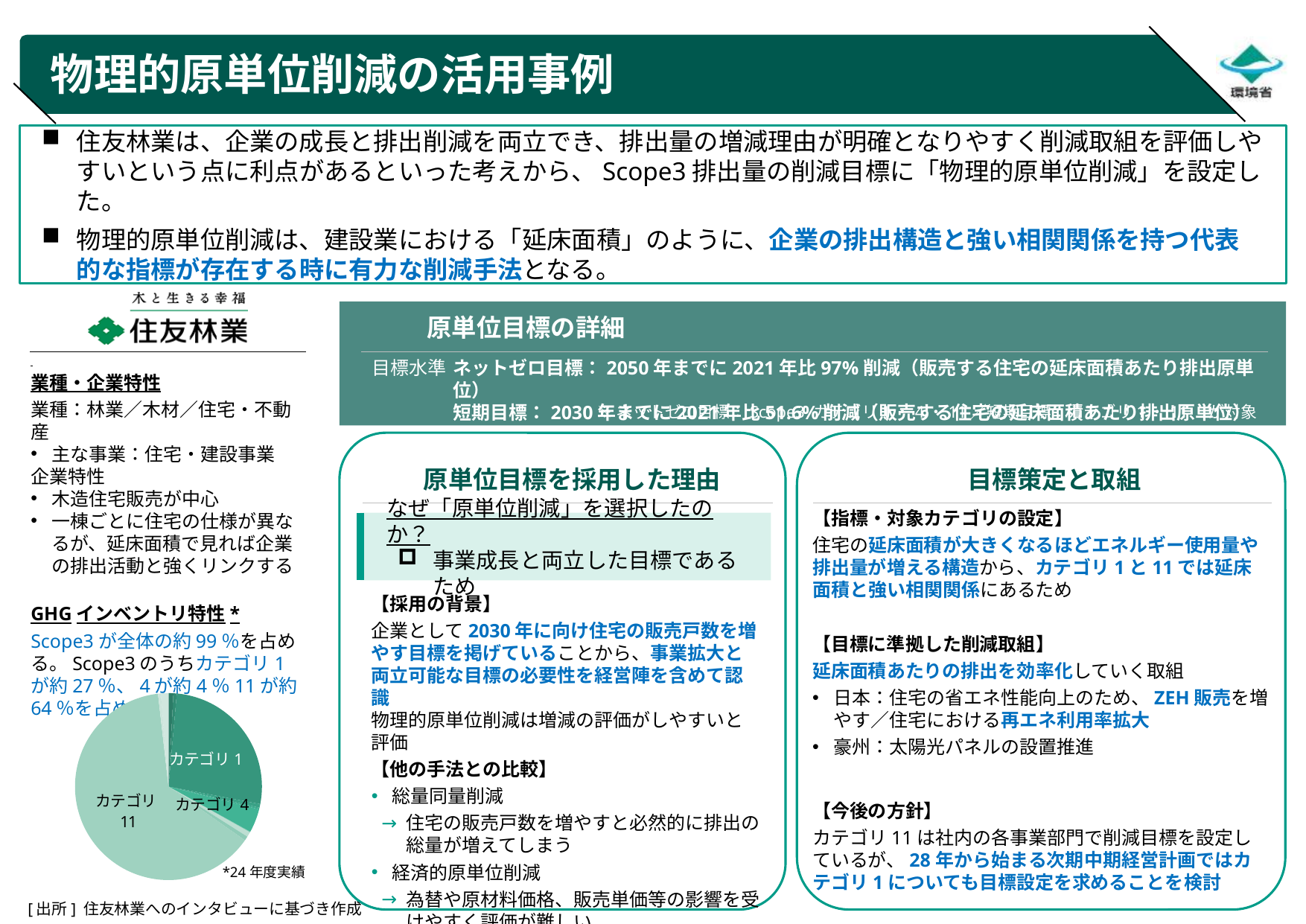
What kind of chart is shown at the bottom left of the slide? pie chart What fiscal year does the footnote under the pie chart say the data is from? 24 年度実績 In the pie chart, which slice is larger: カテゴリ 1 or カテゴリ 11? カテゴリ 11 What are the labels of the three slices in the pie chart? カテゴリ 1, カテゴリ 4, カテゴリ 11 In the pie chart, which slice is larger: カテゴリ 1 or カテゴリ 4? カテゴリ 1 Which category has the largest slice in the pie chart? カテゴリ 11